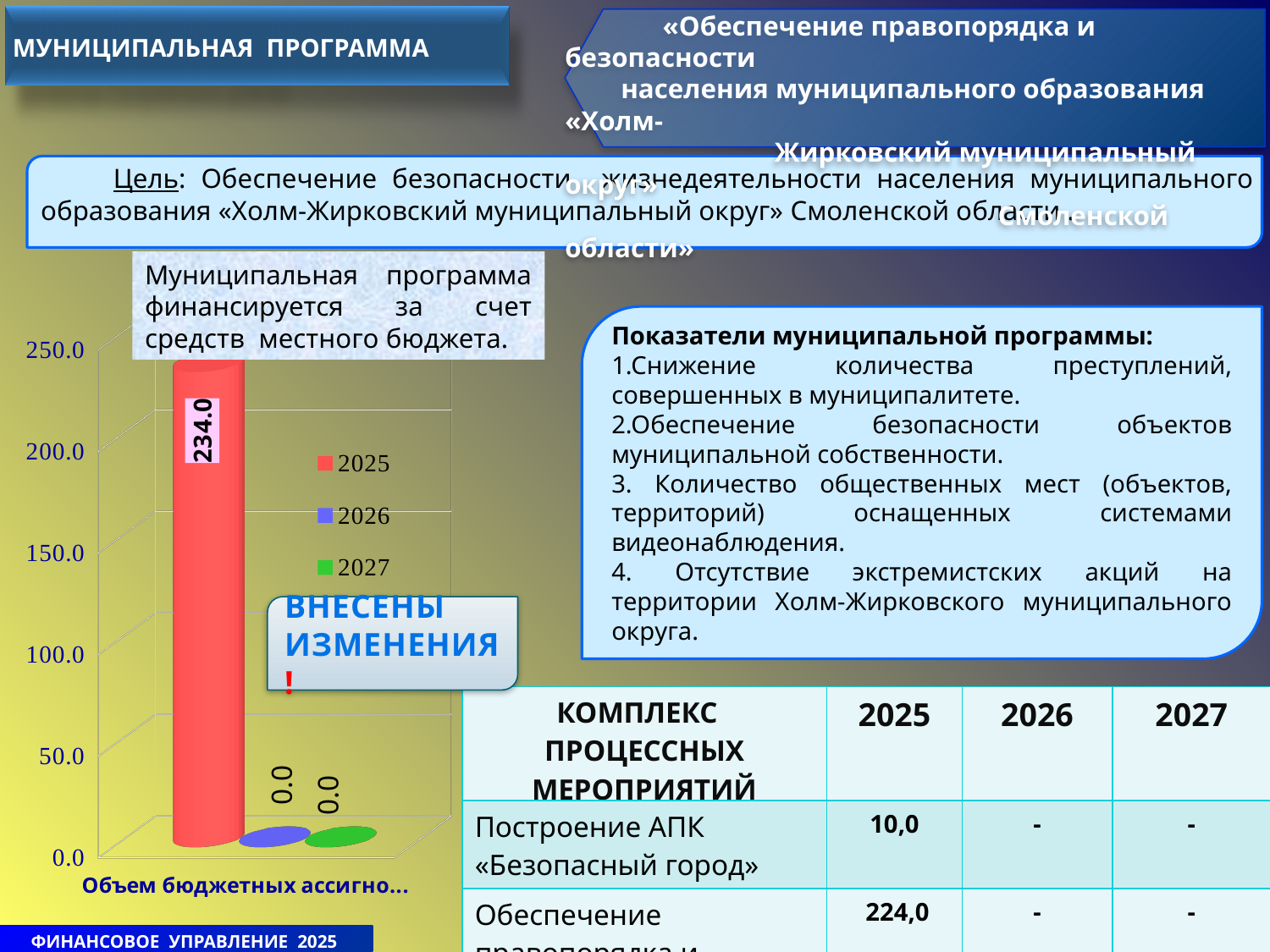
What is the difference between the values for 2025 and 2026 in the chart? 234.0 Which is larger in the chart, the value for 2025 or the value for 2027? 2025 What is the highest value shown on the chart's vertical axis? 250.0 Is the value for 2025 in the chart greater or less than 200.0? greater What kind of chart is shown on the slide? bar chart What colour is the bar for 2025 in the chart? red What is the value shown for 2027 in the chart? 0.0 Which year has the highest value in the chart? 2025 What is the value shown for 2026 in the chart? 0.0 What is the total of the values for 2025, 2026 and 2027 in the chart? 234.0 What is the value shown for 2025 in the chart? 234.0 How many series does the chart legend list? 3